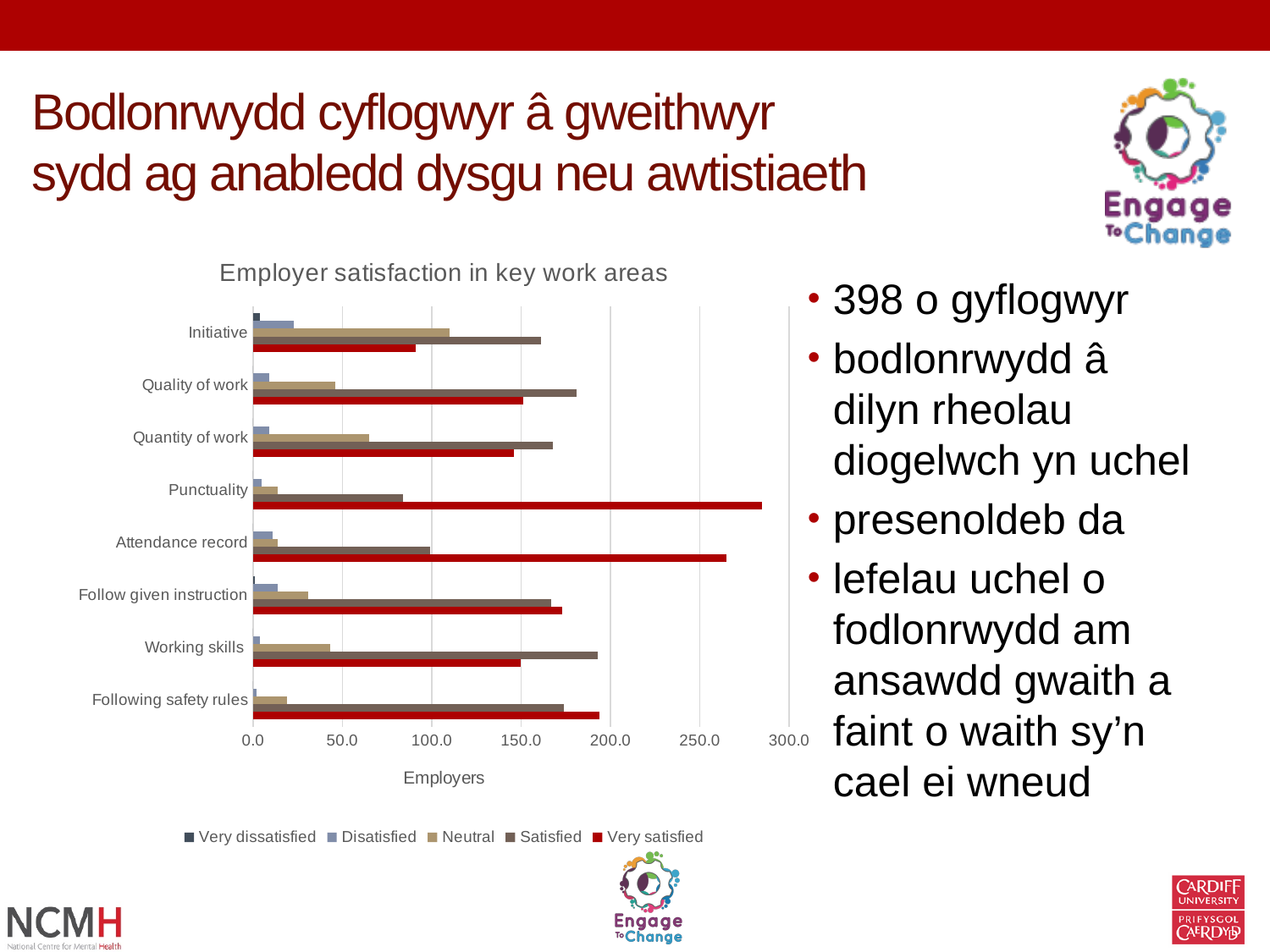
How many work-area categories are plotted on the chart? 8 Is the Very satisfied value for Punctuality greater or less than 250? greater What is the label on the horizontal axis of the chart? Employers What kind of chart is shown on the slide? bar chart What is the title of the chart? Employer satisfaction in key work areas Is the Very satisfied value for Attendance record greater or less than 250? greater Is the Satisfied value for Working skills greater or less than 150? greater How many series does the chart legend list? 5 For Initiative, which is larger: the Neutral value or the Very satisfied value? Neutral Which category has the highest Very satisfied value? Punctuality